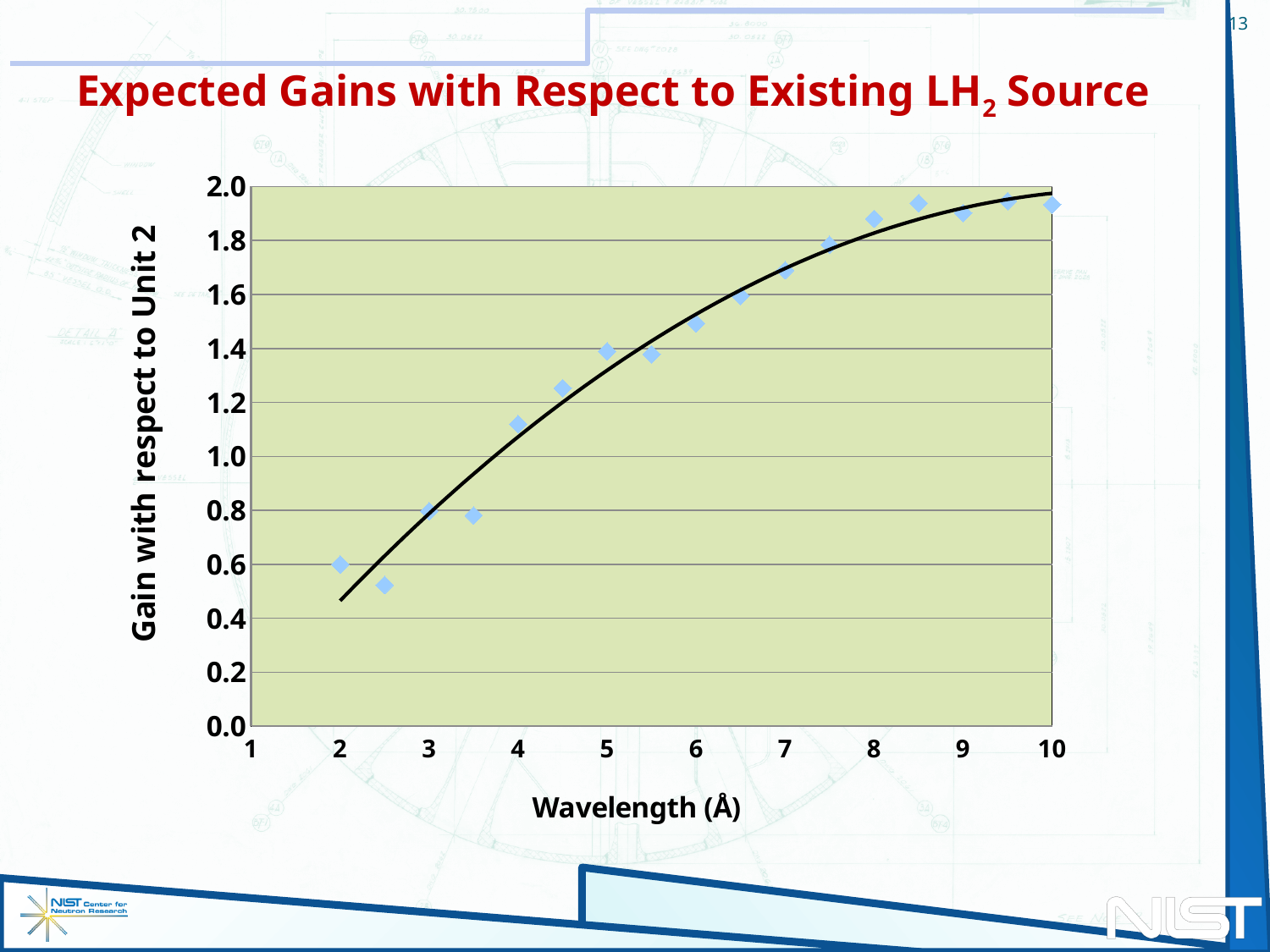
Is the gain at 8 Å greater or less than 1.8? greater What kind of chart is shown on the slide? Scatter plot Is the gain at 7 Å greater or less than 1.6? greater Do the gain values rise or fall as wavelength increases along the x axis? Rise Which has the larger gain, the point at 4 Å or the point at 8 Å? 8 Å How many data points are plotted on the chart? 17 Is the gain at 4 Å greater or less than 1.0? greater At which wavelength is the plotted gain lowest? 2.5 Å What is the label of the x axis? Wavelength (Å) What is the label of the y axis? Gain with respect to Unit 2